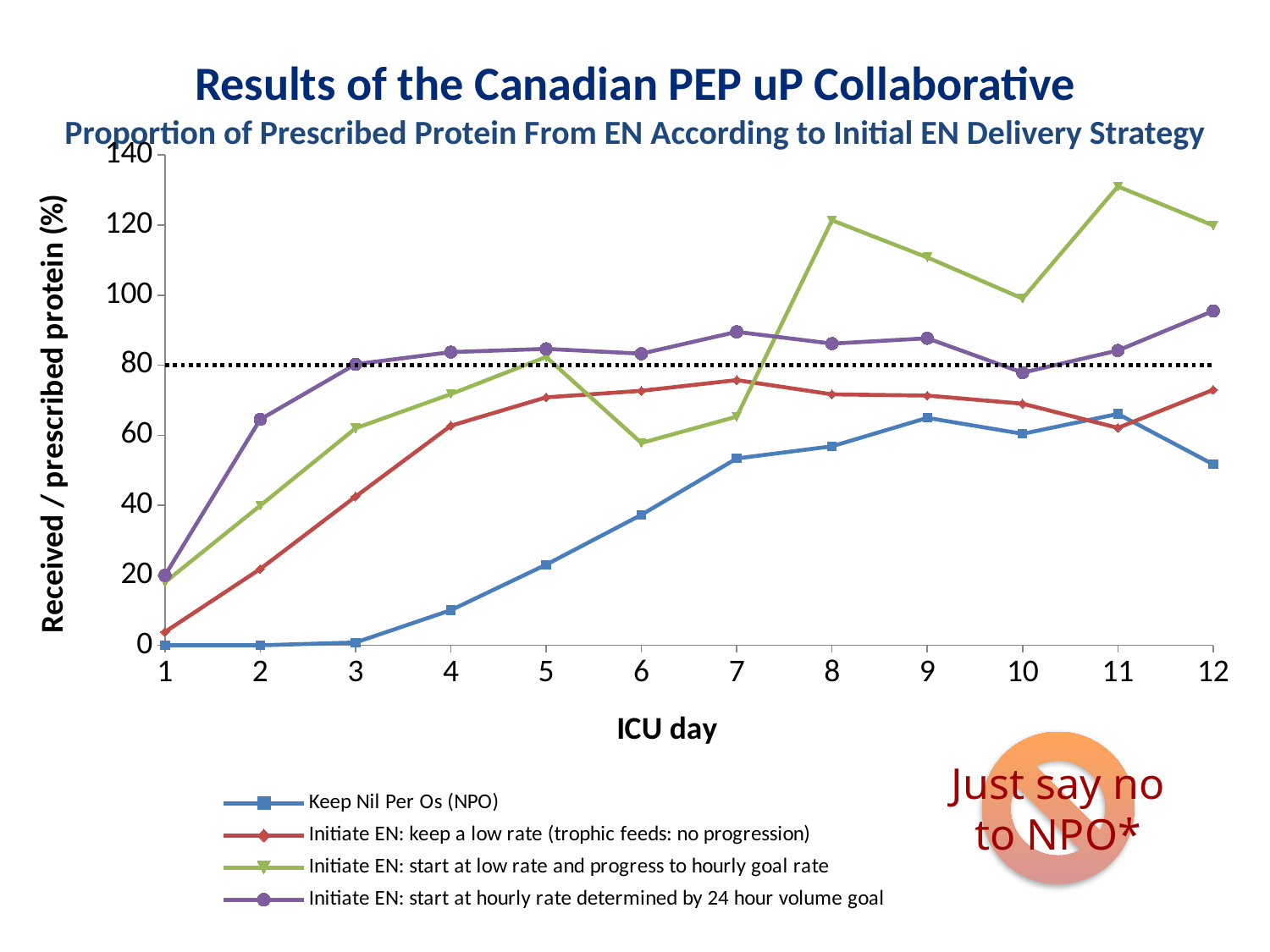
How many series does the legend list? 4 How many ICU days are plotted along the x axis? 12 Does the Keep Nil Per Os (NPO) series rise or fall from ICU day 1 to ICU day 9? rise Which series has the lowest value on ICU day 5? Keep Nil Per Os (NPO) What is the value for Keep Nil Per Os (NPO) on ICU day 1? 0 Is the value for Keep Nil Per Os (NPO) on ICU day 7 greater or less than 40? greater On ICU day 12, which is larger: the value for 'Initiate EN: start at hourly rate determined by 24 hour volume goal' or the value for 'Initiate EN: keep a low rate (trophic feeds: no progression)'? Initiate EN: start at hourly rate determined by 24 hour volume goal What kind of chart is shown on the slide? line chart Is the value for 'Initiate EN: keep a low rate (trophic feeds: no progression)' on ICU day 3 greater or less than 60? less Is the value for 'Initiate EN: start at hourly rate determined by 24 hour volume goal' on ICU day 2 greater or less than 60? greater Which series has the highest value on ICU day 11? Initiate EN: start at low rate and progress to hourly goal rate